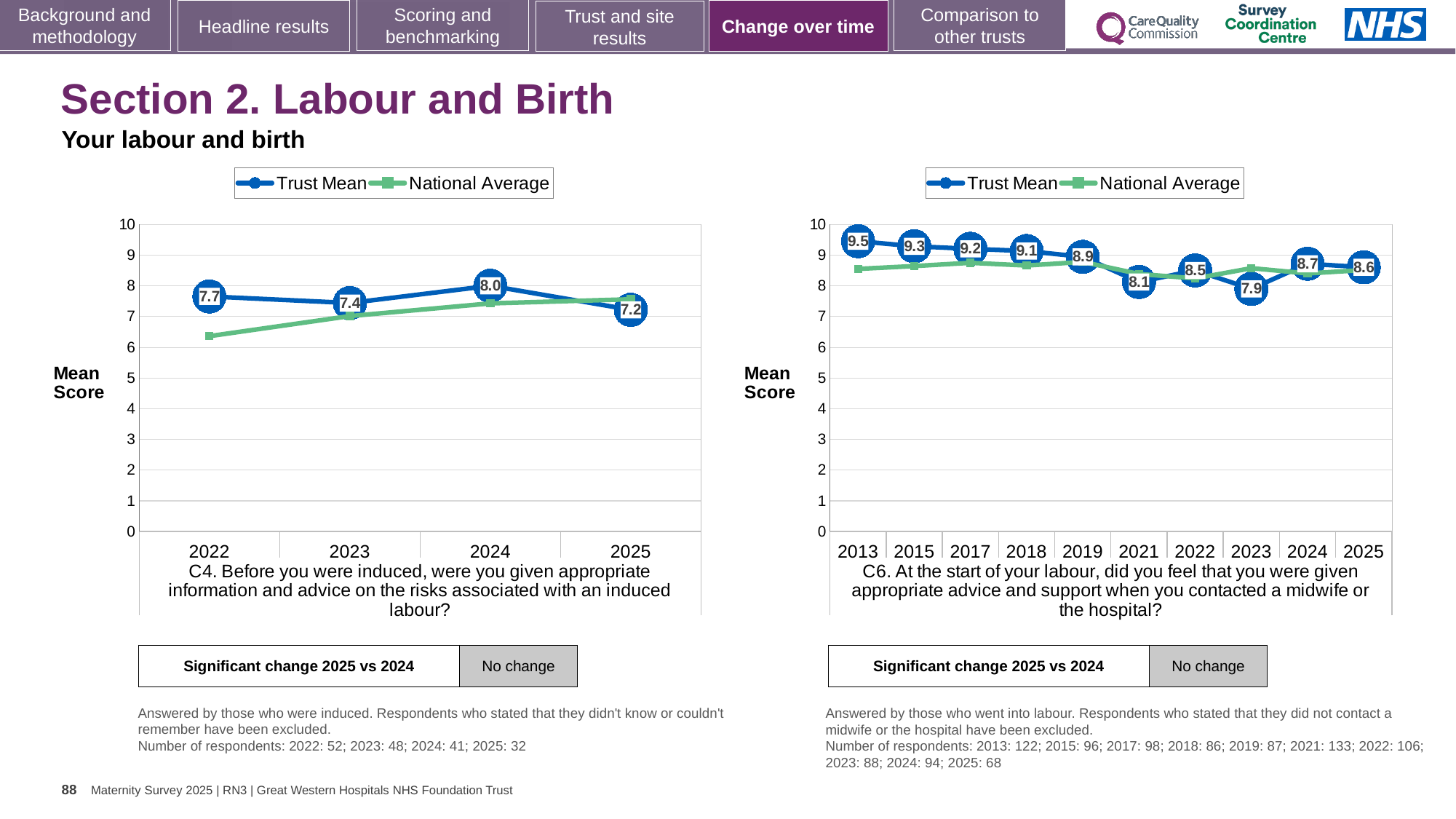
In the C6 chart on the right, is the Trust Mean score for 2021 larger or smaller than the score for 2022? smaller In the C4 chart on the left, what is the Trust Mean score for 2024? 8.0 In the C6 chart on the right, how many series does the legend list? 2 In the C4 chart on the left, how many years are shown on the x axis? 4 In the C4 chart on the left, what is the Trust Mean score for 2025? 7.2 In the C6 chart on the right, which year has the lowest Trust Mean score? 2023 In the C4 chart on the left, which year has the highest Trust Mean score? 2024 In the C6 chart on the right, what is the difference between the Trust Mean scores for 2013 and 2025? 0.9 What type of chart is used for the C6 question on the right? Line chart In the C4 chart on the left, what is the difference between the Trust Mean scores for 2024 and 2025? 0.8 In the C6 chart on the right, what is the Trust Mean score for 2013? 9.5 In the C4 chart on the left, is the National Average value for 2022 greater or less than 7? less